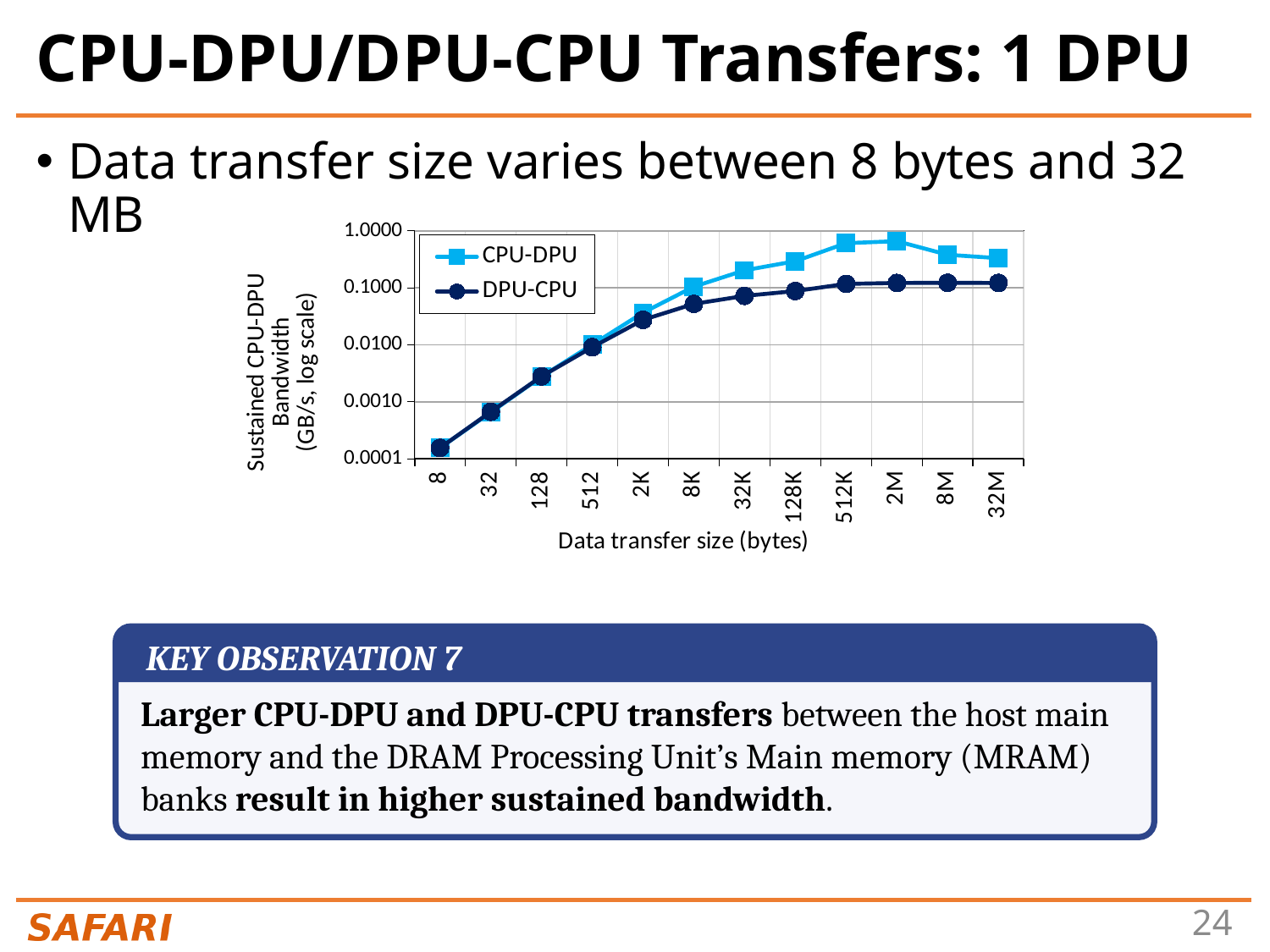
At a data transfer size of 8 bytes, is the DPU-CPU bandwidth greater or less than 0.0010 GB/s? less What is the label of the x axis of the chart? Data transfer size (bytes) At a data transfer size of 2K, is the DPU-CPU bandwidth greater or less than 0.0100 GB/s? greater Does the sustained bandwidth for CPU-DPU generally rise or fall as the data transfer size increases from 8 bytes to 512K? rise What are the two series named in the chart legend? CPU-DPU and DPU-CPU How many series does the chart legend list? 2 How many data transfer sizes are shown along the x axis of the chart? 12 At a data transfer size of 32K, is the CPU-DPU bandwidth greater or less than 1.0000 GB/s? less At a data transfer size of 32M, which series has the higher sustained bandwidth, CPU-DPU or DPU-CPU? CPU-DPU What kind of chart is shown on the slide? line chart For the DPU-CPU series, at which data transfer size is the sustained bandwidth lowest? 8